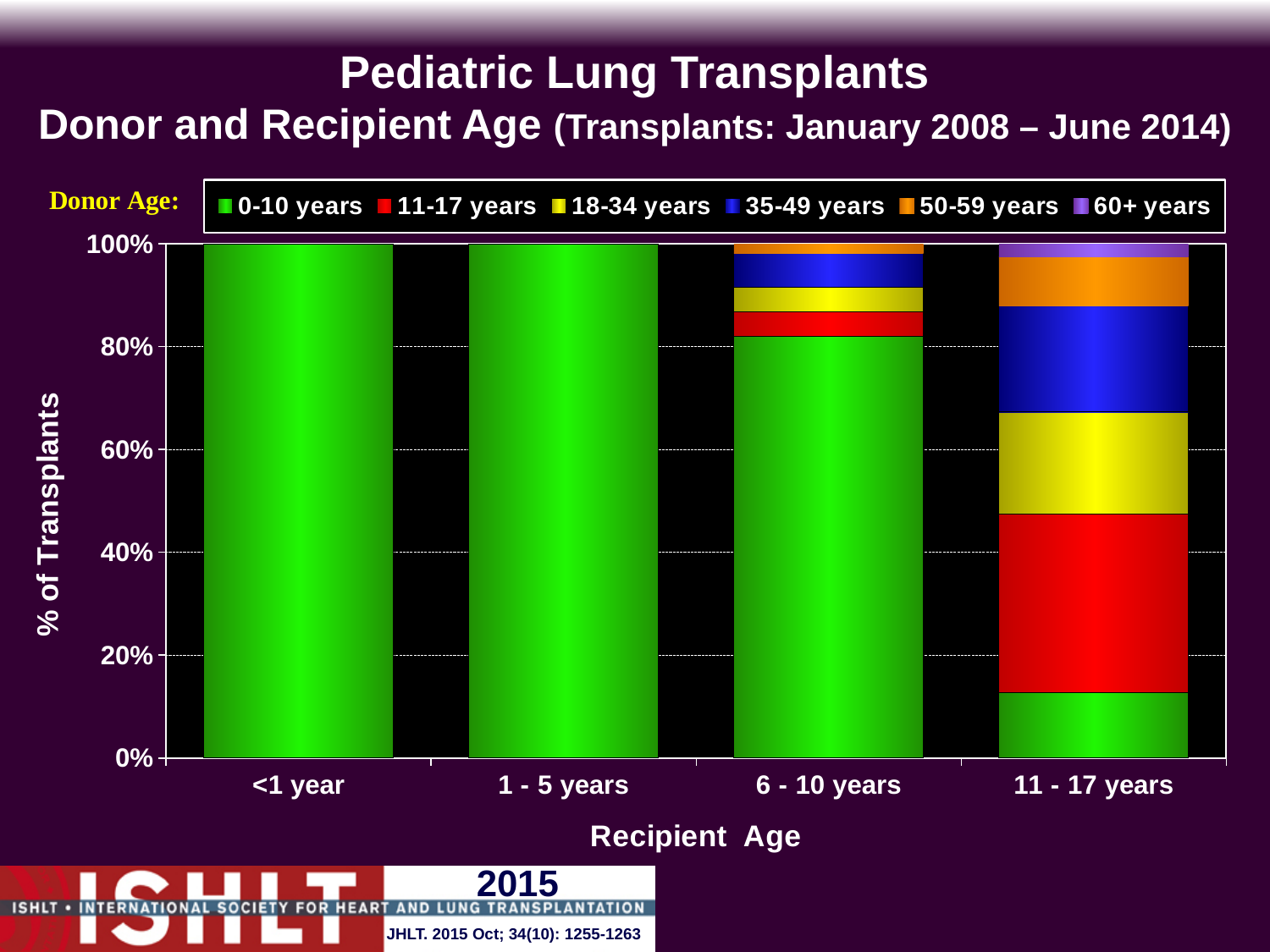
How many recipient age categories are shown on the x axis? 4 What kind of chart is shown on the slide? stacked bar chart What label is given to the legend describing the series? Donor Age: Is the share of 0-10 years donors for recipients aged 11 - 17 years greater or less than 20%? less Does the share of 0-10 years donors rise or fall as recipient age increases along the x axis? fall How many donor age series does the legend list? 6 What percentage of transplants for recipients aged <1 year had donors aged 0-10 years? 100% What is the title of the x axis? Recipient Age Which recipient age group has the smallest share of 0-10 years donors? 11 - 17 years Is the share of 0-10 years donors for recipients aged 6 - 10 years greater or less than 80%? greater What percentage of transplants for recipients aged 1 - 5 years had donors aged 0-10 years? 100% Which recipient age group has the larger share of 0-10 years donors: 6 - 10 years or 11 - 17 years? 6 - 10 years